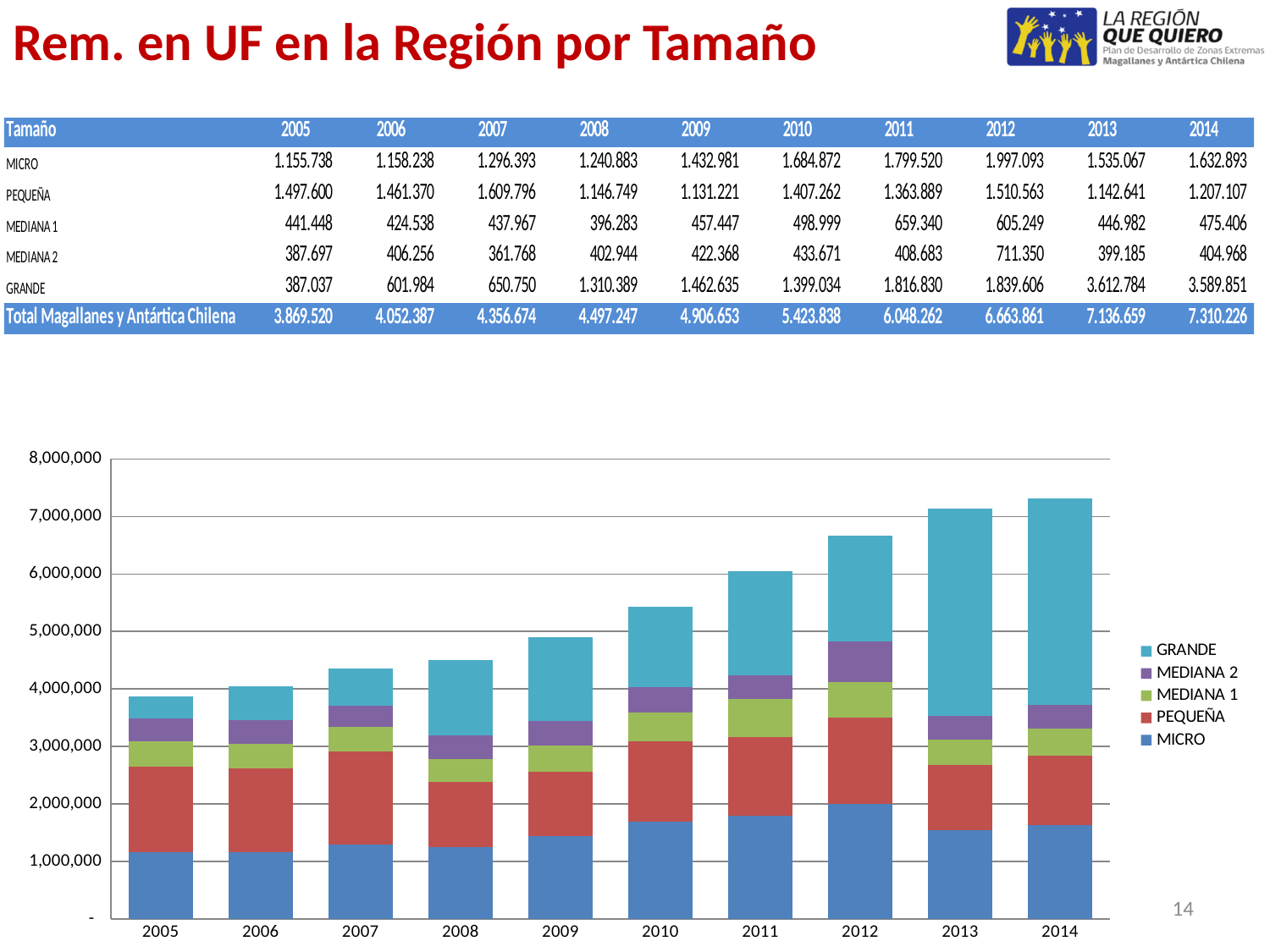
According to the table, what is the GRANDE value for 2013? 3.612.784 Is the total bar for 2012 greater or less than 6,000,000? greater How many years are shown along the x axis of the chart? 10 In 2012, which is larger, the MICRO value or the PEQUEÑA value? MICRO According to the table, what is the Total Magallanes y Antártica Chilena for 2014? 7.310.226 Which series is listed first (at the top) in the chart legend? GRANDE Which year has the tallest stacked bar? 2014 What kind of chart is shown on the slide? bar chart Which year has the shortest stacked bar? 2005 Is the total bar for 2010 greater or less than 5,000,000? greater How many series does the chart legend list? 5 Do the total bar heights rise or fall from 2005 to 2014? rise